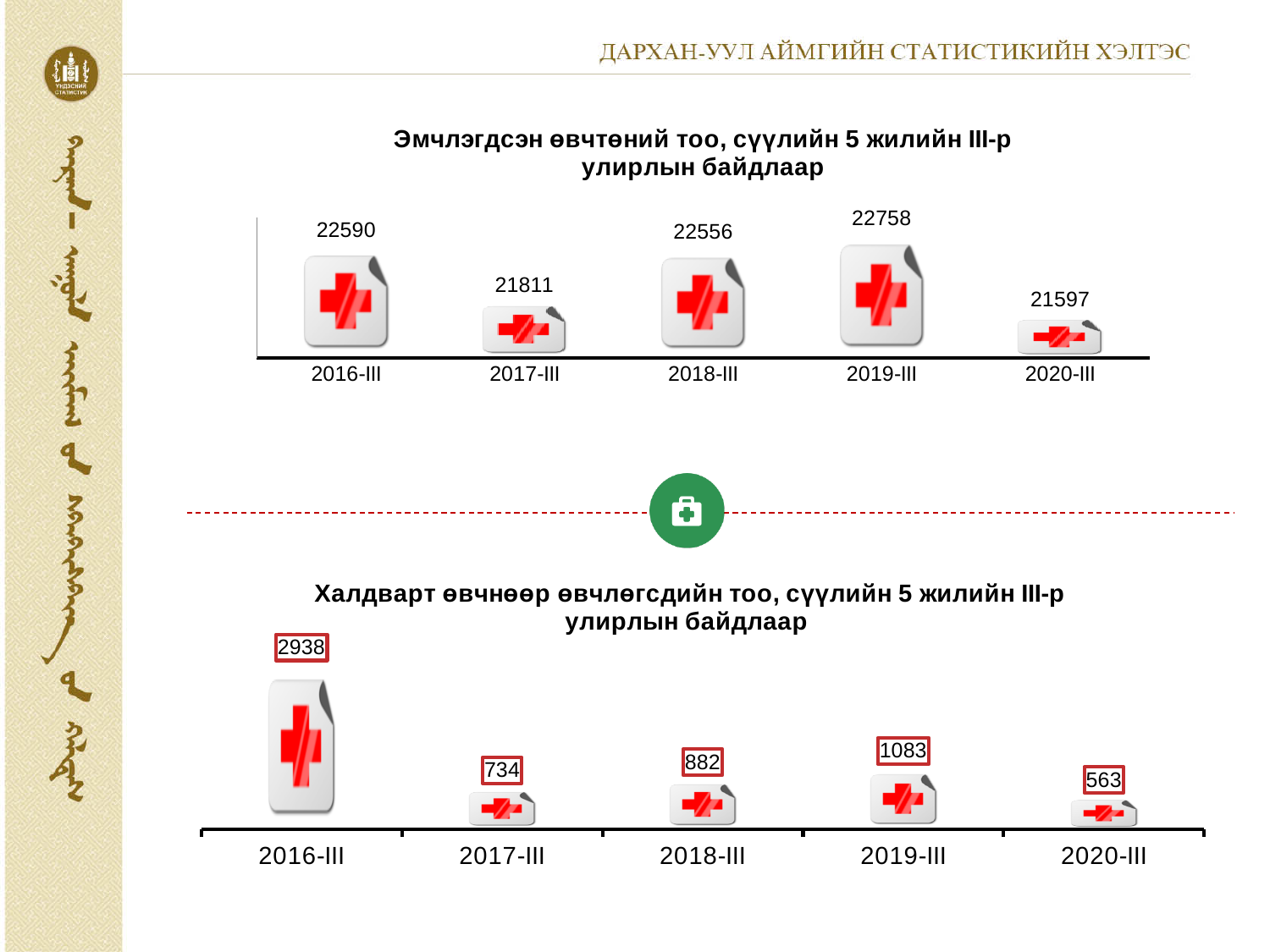
In the top chart (Эмчлэгдсэн өвчтөний тоо), which period has the highest value? 2019-III In the bottom chart (Халдварт өвчнөөр өвчлөгсдийн тоо), which is larger, the value for 2017-III or 2018-III? 2018-III What kind of chart is the bottom chart (Халдварт өвчнөөр өвчлөгсдийн тоо)? bar chart In the bottom chart (Халдварт өвчнөөр өвчлөгсдийн тоо), what is the difference between the values for 2016-III and 2020-III? 2375 In the bottom chart (Халдварт өвчнөөр өвчлөгсдийн тоо), which period has the lowest value? 2020-III In the bottom chart (Халдварт өвчнөөр өвчлөгсдийн тоо), what is the value for 2016-III? 2938 In the top chart (Эмчлэгдсэн өвчтөний тоо), what is the value for 2020-III? 21597 In the top chart (Эмчлэгдсэн өвчтөний тоо), what is the difference between the values for 2019-III and 2017-III? 947 In the bottom chart (Халдварт өвчнөөр өвчлөгсдийн тоо), what is the value for 2019-III? 1083 In the top chart (Эмчлэгдсэн өвчтөний тоо), what is the value for 2016-III? 22590 In the top chart (Эмчлэгдсэн өвчтөний тоо), how many periods are shown? 5 In the top chart (Эмчлэгдсэн өвчтөний тоо), which period has the lowest value? 2020-III